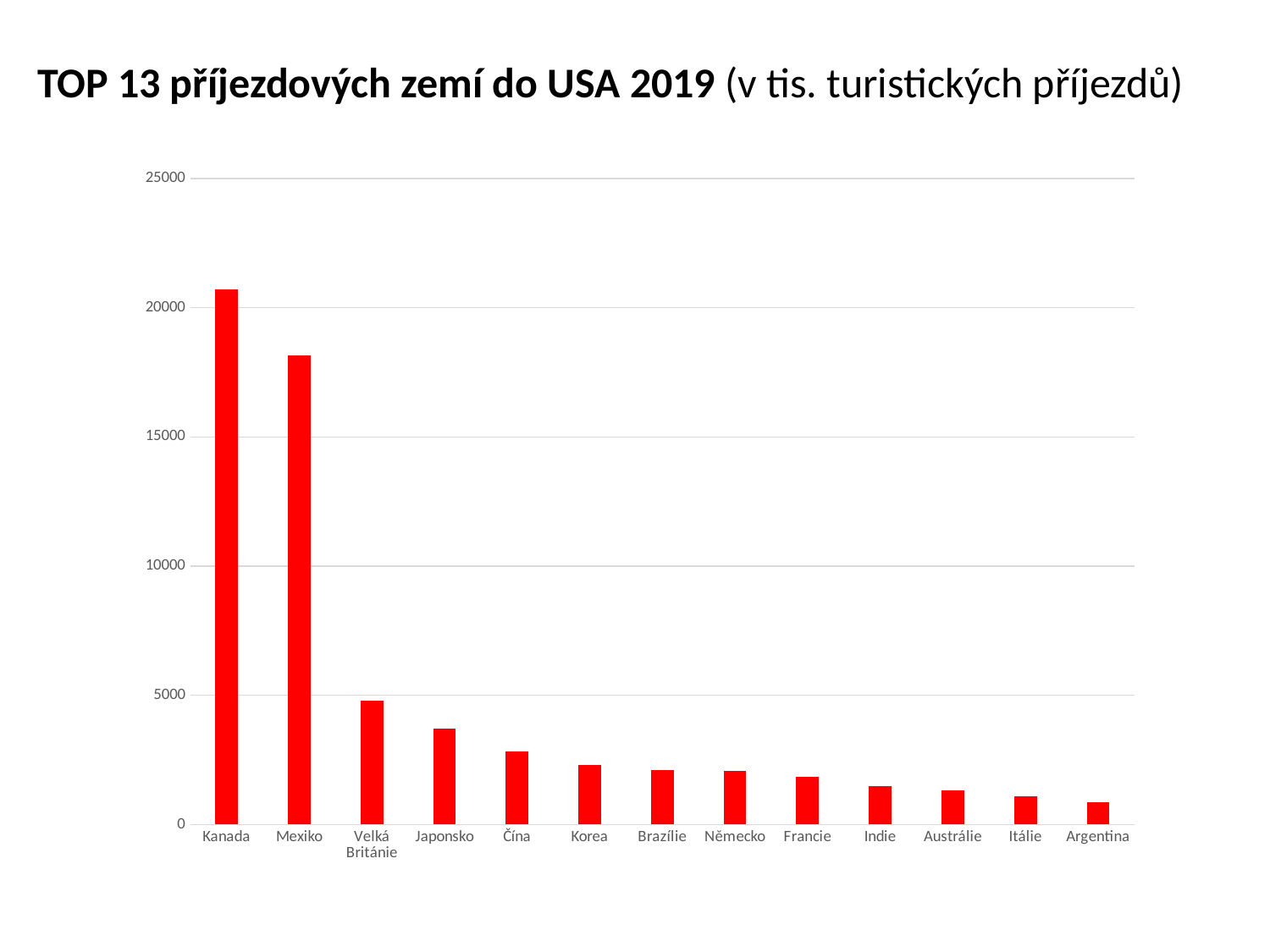
Which country has the highest number of tourist arrivals to the USA in 2019? Kanada Which country has the lowest number of tourist arrivals to the USA in 2019? Argentina What is the title of the chart? TOP 13 příjezdových zemí do USA 2019 (v tis. turistických příjezdů) Which has a larger value, Kanada or Mexiko? Kanada Which has a larger value, Velká Británie or Japonsko? Velká Británie Is the value for Japonsko greater or less than 5000? less Is the value for Kanada greater or less than 15000? greater What kind of chart is shown on the slide? bar chart How many countries are shown on the chart? 13 Is the value for Mexiko greater or less than 15000? greater Do the values rise or fall from left to right along the x axis? fall